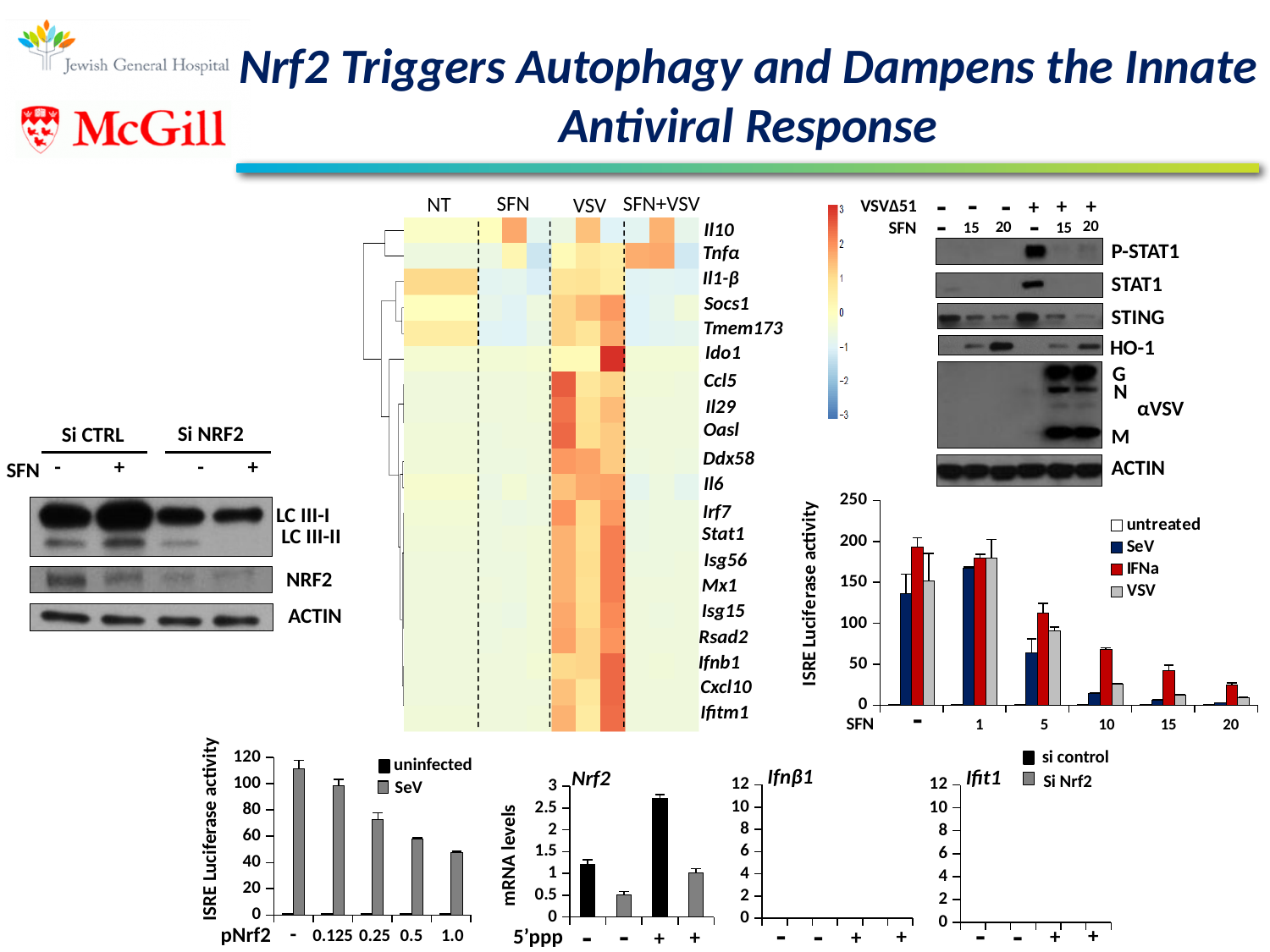
In the bottom-left ISRE Luciferase activity chart (x axis pNrf2), how many series does the legend list? 2 In the ISRE Luciferase activity chart on the right (x axis SFN), do the IFNa values rise or fall as SFN increases along the x axis? fall In the bottom-left ISRE Luciferase activity chart (x axis pNrf2), which pNrf2 category has the highest SeV value? - In the ISRE Luciferase activity chart on the right (x axis SFN), how many series does the legend list? 4 What kind of chart is the bottom-left ISRE Luciferase activity chart (x axis pNrf2)? bar chart In the ISRE Luciferase activity chart on the right (x axis SFN), is the IFNa value at SFN 10 greater or less than 100? less In the ISRE Luciferase activity chart on the right (x axis SFN), how many SFN categories are shown on the x axis? 6 In the bottom-left ISRE Luciferase activity chart (x axis pNrf2), how many pNrf2 categories are on the x axis? 5 In the ISRE Luciferase activity chart on the right (x axis SFN), at SFN 5, which is larger, the SeV bar or the IFNa bar? IFNa In the Nrf2 mRNA levels chart at the bottom, is the si control value at 5'ppp + greater or less than 2? greater In the bottom-left ISRE Luciferase activity chart (x axis pNrf2), is the SeV value at pNrf2 1.0 greater or less than 60? less